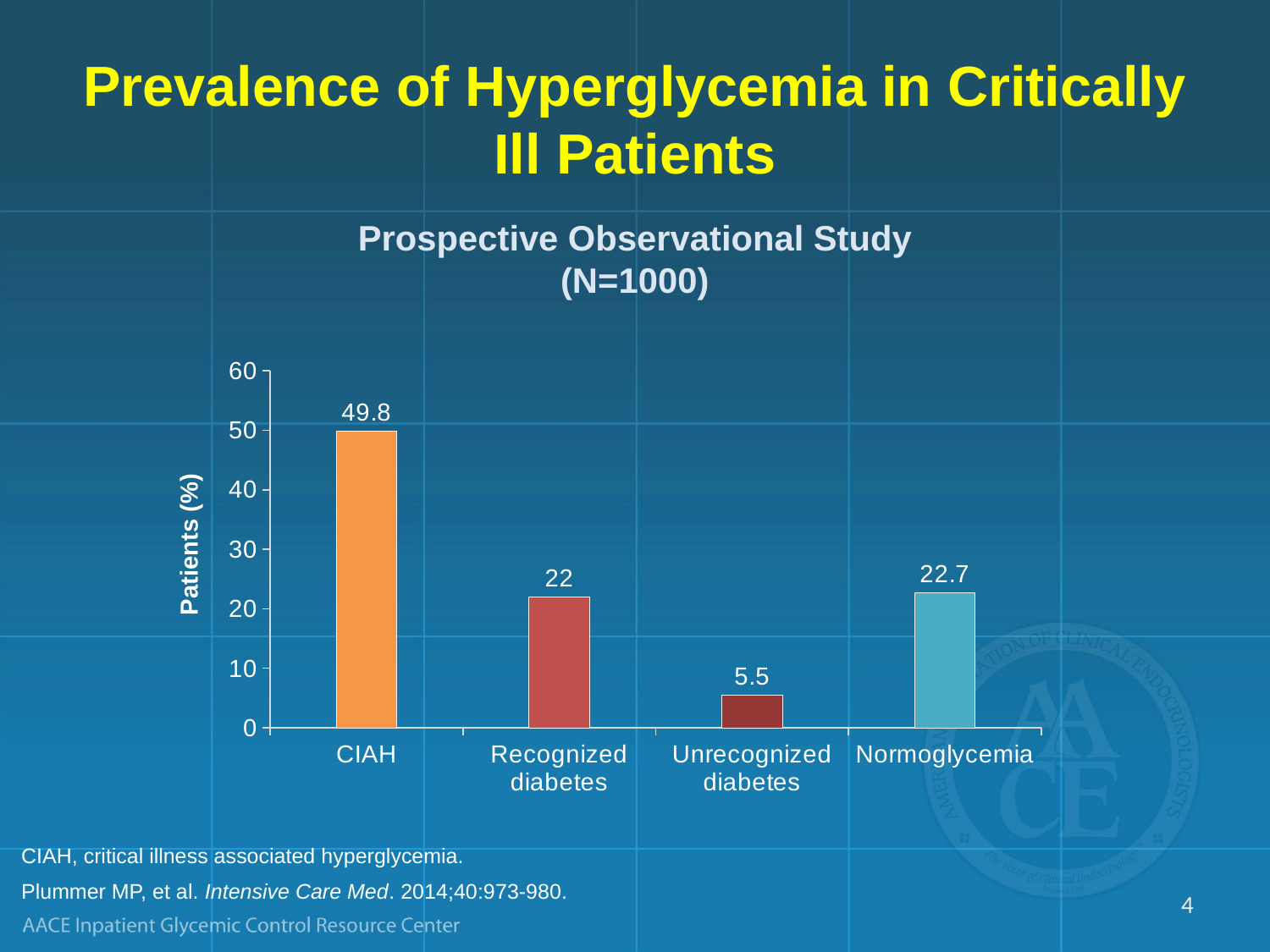
How many categories are shown on the x axis? 4 What kind of chart is shown on the slide? Bar chart Which category has the highest value? CIAH What is the value for Normoglycemia? 22.7 Which is larger, the value for CIAH or the value for Recognized diabetes? CIAH What is the value for CIAH? 49.8 What is the value for Unrecognized diabetes? 5.5 What is the difference between the values for Recognized diabetes and Unrecognized diabetes? 16.5 What is the value for Recognized diabetes? 22 Which category has the lowest value? Unrecognized diabetes What is the difference between the values for CIAH and Normoglycemia? 27.1 What is the label of the y axis? Patients (%)